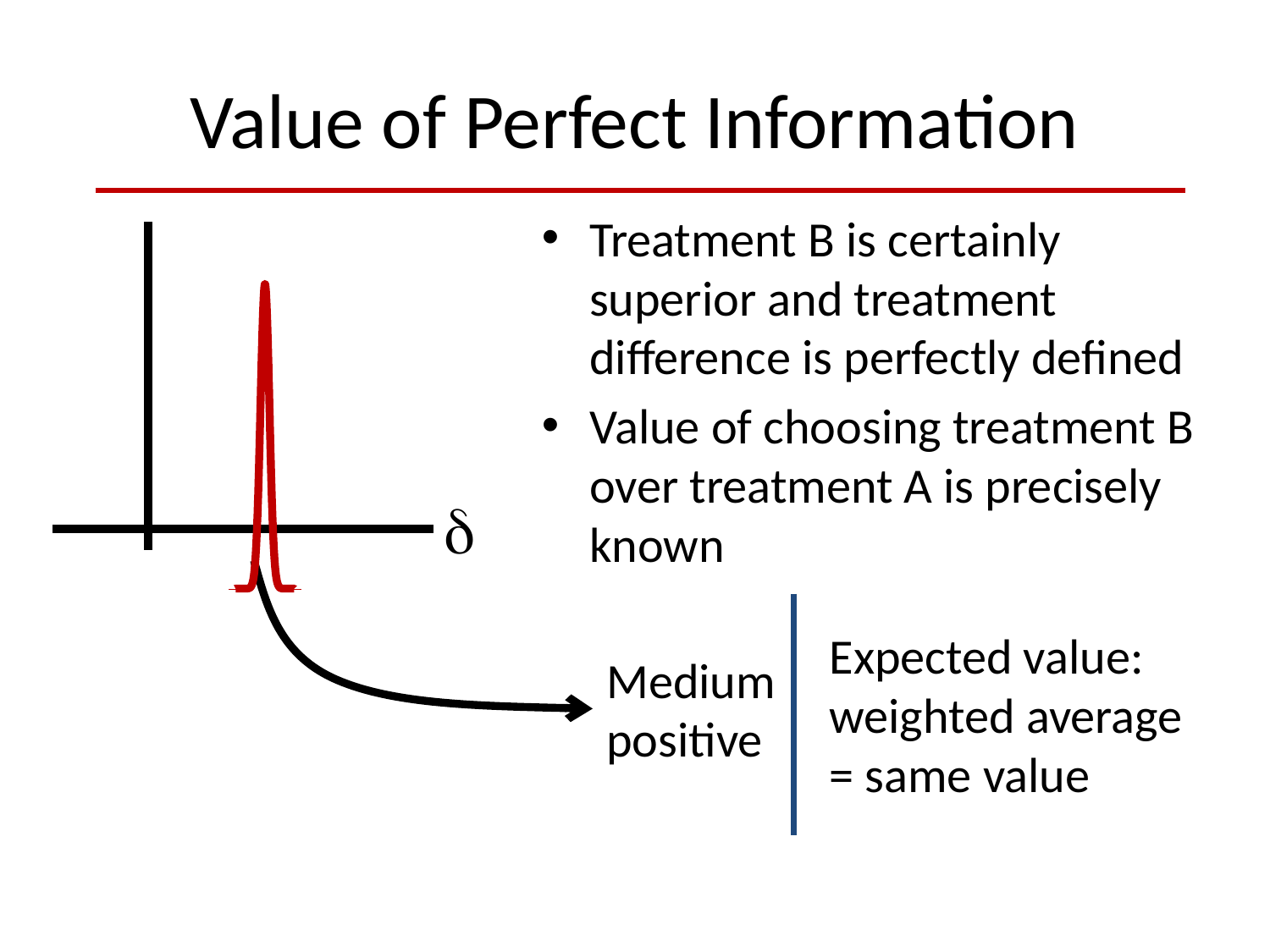
What symbol labels the horizontal axis of the plot on the left of the slide? δ Is the peak of the red curve located to the left or to the right of the vertical axis? Right How many peaks does the red curve on the plot have? 1 What label does the arrow from the red curve point to? Medium positive What colour is the curve drawn on the plot on the left of the slide? Red